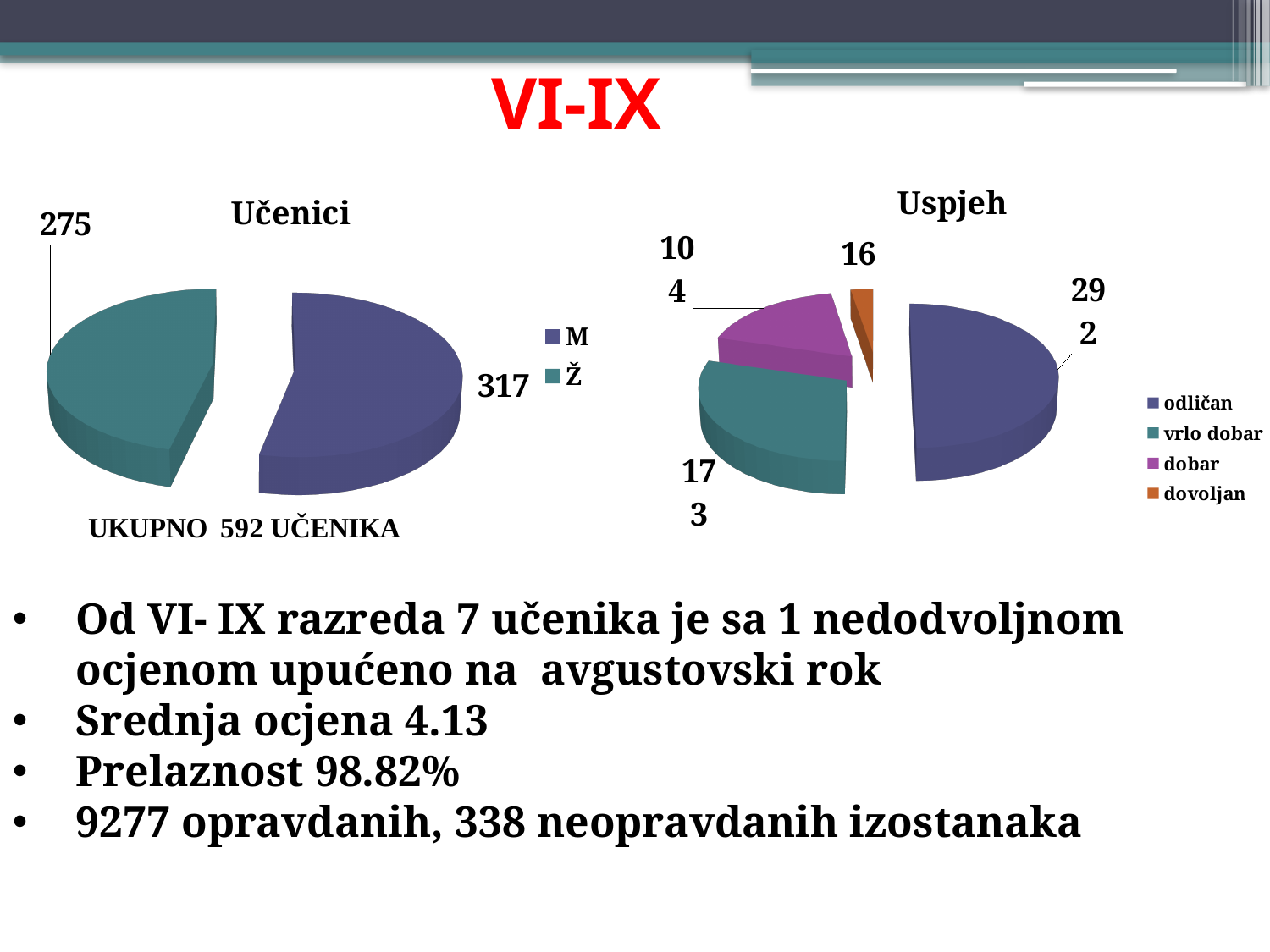
In the Učenici chart, what is the difference between the M and Ž values? 42 In the Učenici chart, what is the value for Ž? 275 In the Uspjeh chart, which slice is larger, vrlo dobar or dobar? vrlo dobar In the Uspjeh chart, what is the value for dovoljan? 16 In the Uspjeh chart, which category has the largest slice? odličan What kind of chart is the Učenici chart? pie chart In the Uspjeh chart, which category has the smallest slice? dovoljan How many categories does the legend of the Uspjeh chart list? 4 In the Učenici chart, which category is larger, M or Ž? M What is the title of the chart on the right side of the slide? Uspjeh In the Učenici chart, what is the value for M? 317 In the Učenici chart, how many slices does the pie have? 2